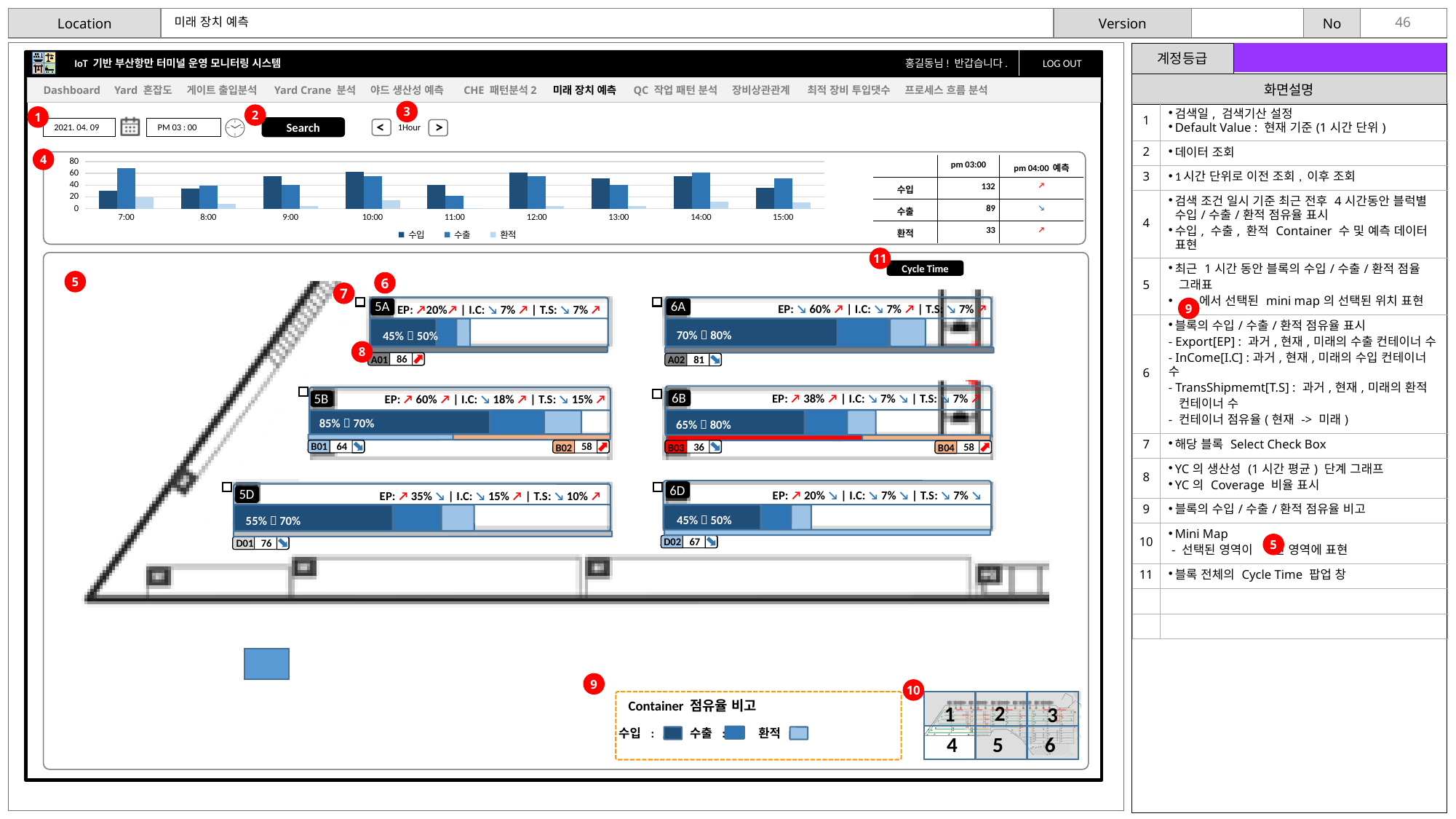
In the top bar chart, which is larger at 11:00, 수입 or 수출? 수입 In the top bar chart, at which time is the 환적 bar highest? 7:00 In the top bar chart, is the 환적 value at 7:00 greater or less than 40? less In the top bar chart, is the 수출 value at 11:00 greater or less than 40? less In the top bar chart, is the 수입 value at 10:00 greater or less than 40? greater What are the legend entries of the top bar chart? 수입, 수출, 환적 How many series does the legend of the top bar chart list? 3 What kind of chart is shown at the top of the screen (item 4)? bar chart What is the highest tick value shown on the y axis of the top bar chart? 80 In the top bar chart, at which time is the 수출 bar highest? 7:00 In the top bar chart, which is larger at 7:00, 수입 or 수출? 수출 How many time categories are shown on the x axis of the top bar chart? 9